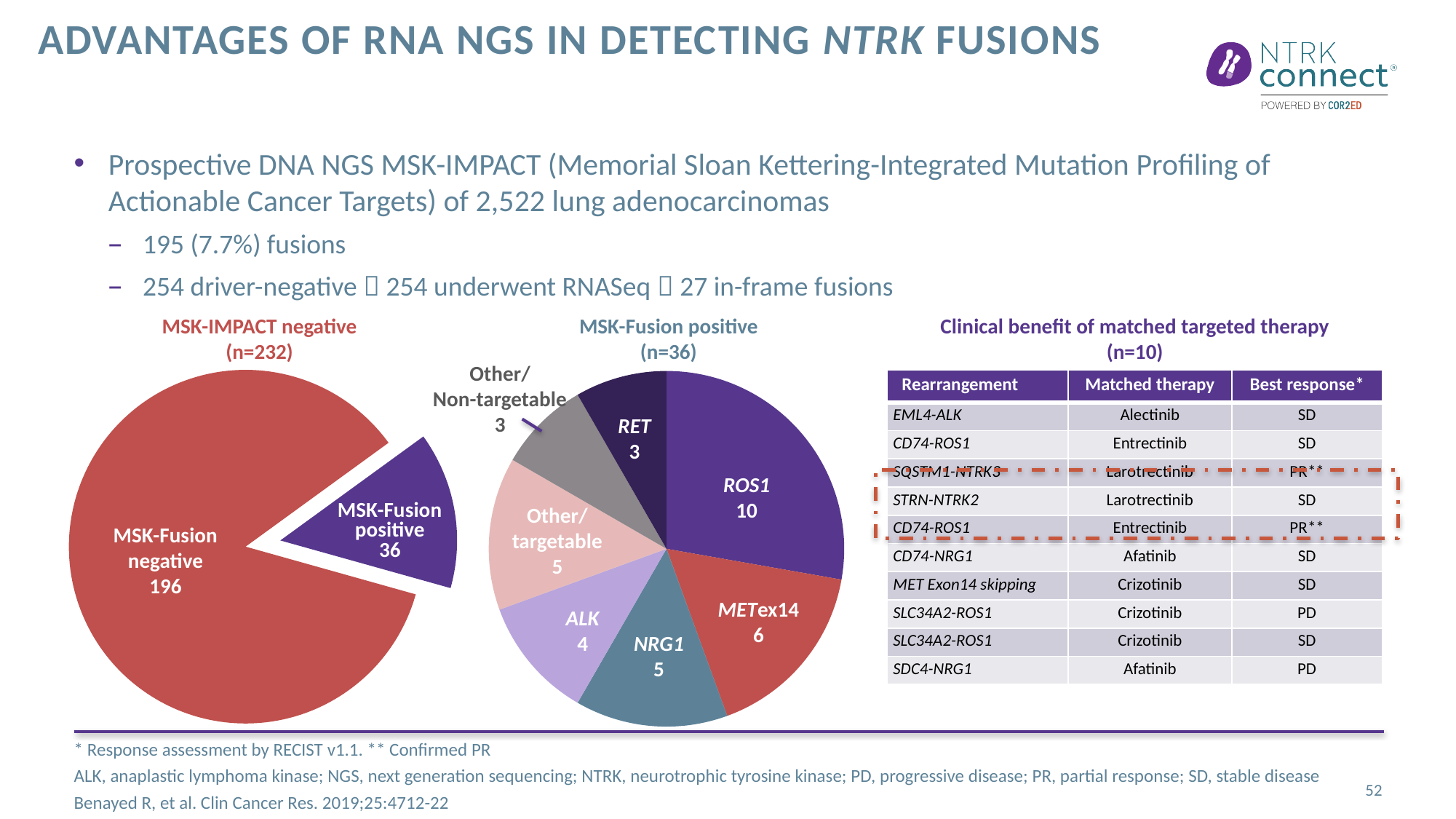
In the MSK-Fusion positive (n=36) pie chart, how many categories are shown? 7 In the MSK-Fusion positive (n=36) pie chart, what is the value for METex14? 6 In the MSK-Fusion positive (n=36) pie chart, which is larger, NRG1 or ALK? NRG1 In the MSK-IMPACT negative (n=232) pie chart, what is the value for MSK-Fusion positive? 36 In the MSK-Fusion positive (n=36) pie chart, what is the value for ROS1? 10 In the MSK-Fusion positive (n=36) pie chart, what is the value for Other/Non-targetable? 3 In the MSK-Fusion positive (n=36) pie chart, what is the difference between ROS1 and RET? 7 What kind of chart is the MSK-IMPACT negative (n=232) chart? Pie chart In the MSK-IMPACT negative (n=232) pie chart, what is the value for MSK-Fusion negative? 196 In the MSK-IMPACT negative (n=232) pie chart, what is the difference between MSK-Fusion negative and MSK-Fusion positive? 160 In the MSK-IMPACT negative (n=232) pie chart, what colour is the MSK-Fusion positive slice? Purple In the MSK-Fusion positive (n=36) pie chart, which category has the largest slice? ROS1